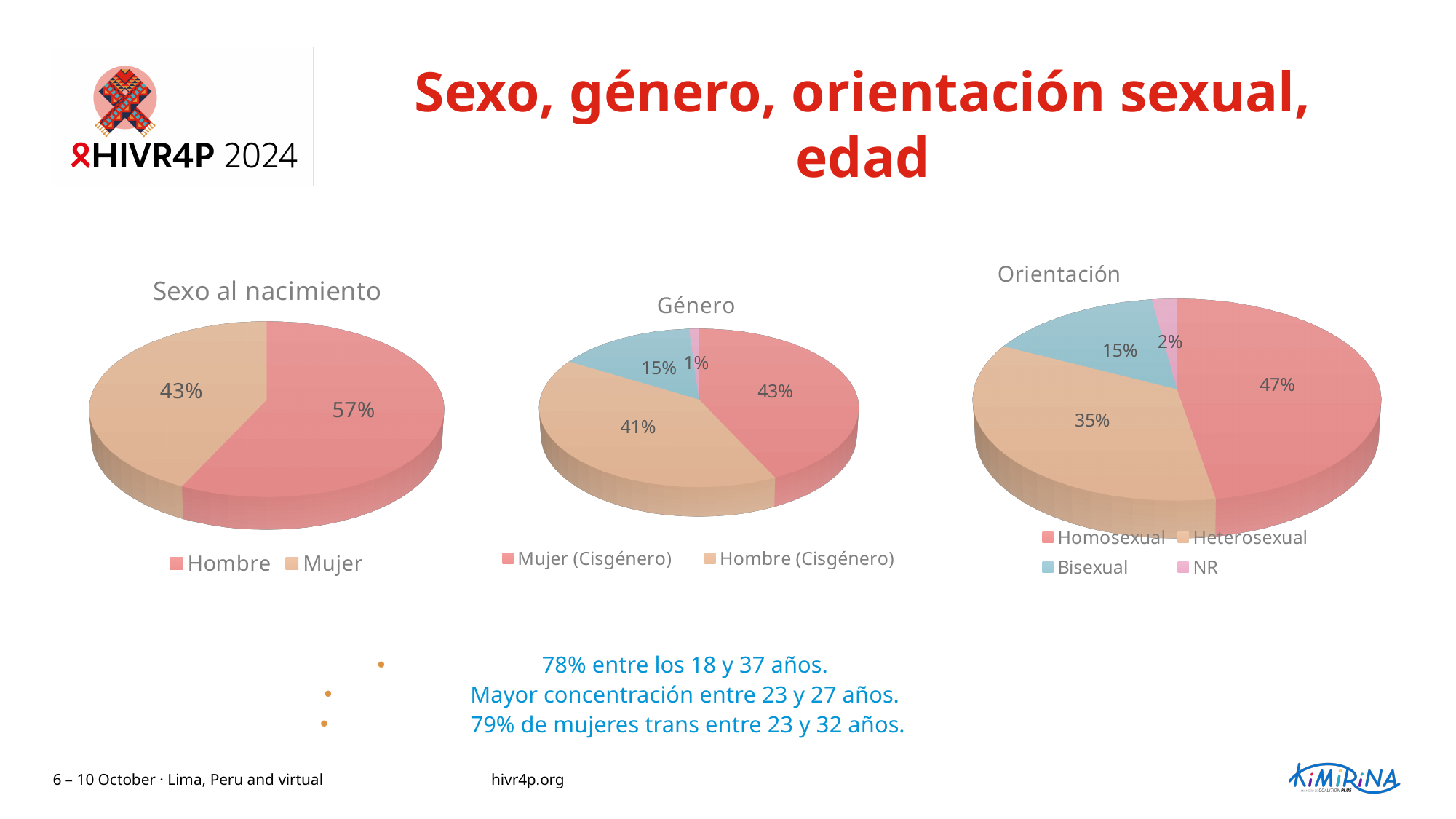
In the 'Género' pie chart, which is larger: Mujer (Cisgénero) or Hombre (Cisgénero)? Mujer (Cisgénero) In the 'Género' pie chart, what percentage is shown for Hombre (Cisgénero)? 41% In the 'Orientación' pie chart, what percentage is shown for Bisexual? 15% What kind of chart is the 'Sexo al nacimiento' chart? Pie chart In the 'Sexo al nacimiento' pie chart, what percentage is shown for Mujer? 43% In the 'Género' pie chart, what percentage is shown for Mujer (Cisgénero)? 43% In the 'Orientación' pie chart, what percentage is shown for Homosexual? 47% In the 'Sexo al nacimiento' pie chart, what is the difference in percentage points between Hombre and Mujer? 14% In the 'Orientación' pie chart, which category has the largest share? Homosexual In the 'Sexo al nacimiento' pie chart, what percentage is shown for Hombre? 57% In the 'Orientación' pie chart, how many categories does the legend list? 4 In the 'Orientación' pie chart, which category has the smallest share? NR